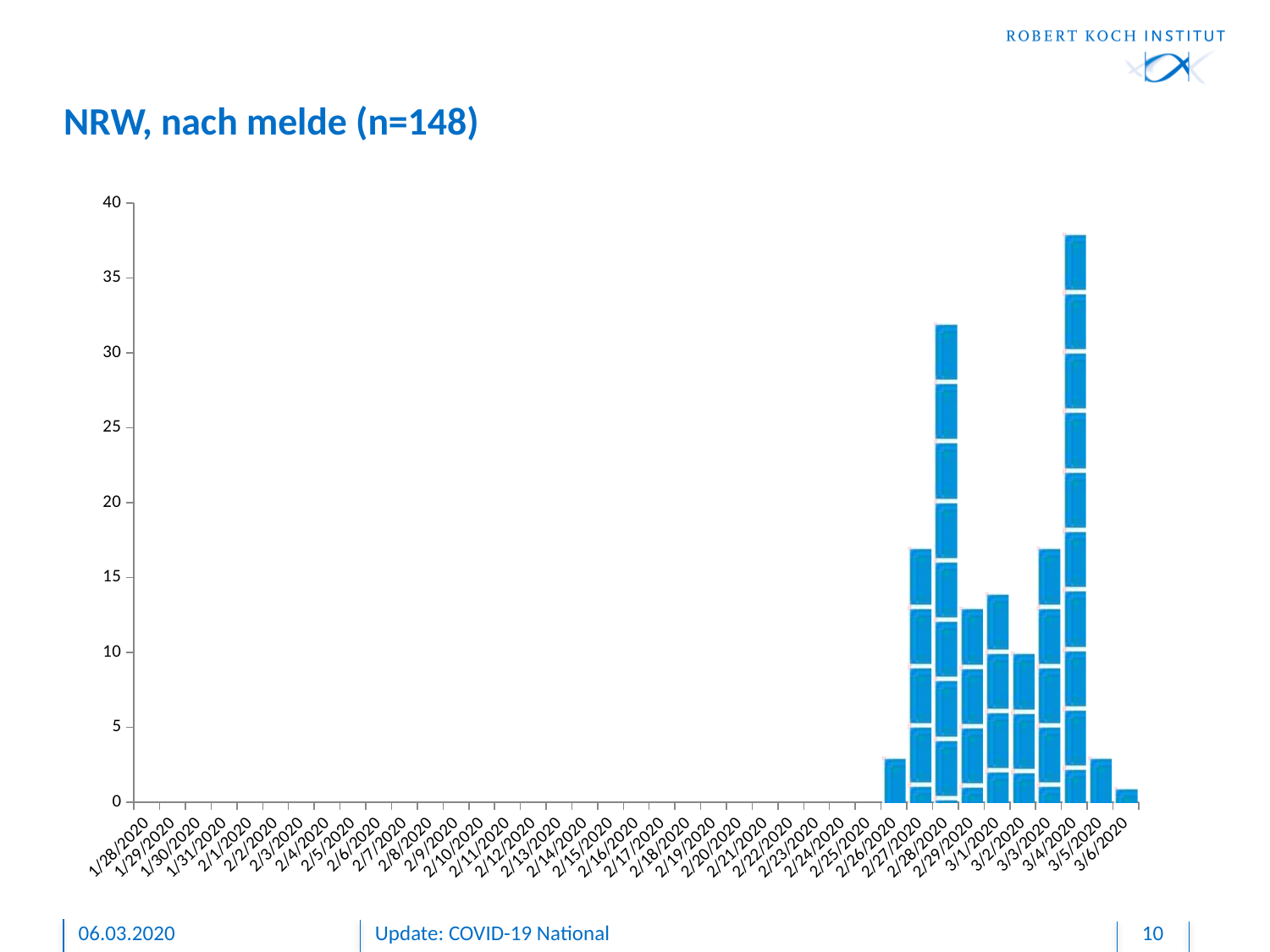
Which is larger, the value for 2/29/2020 or the value for 3/2/2020? 2/29/2020 Is the value for 3/6/2020 greater or less than 5? less Is the value for 3/2/2020 greater or less than 15? less Is the value for 2/26/2020 greater or less than 5? less Which is larger, the value for 2/28/2020 or the value for 3/4/2020? 3/4/2020 Which date has the highest bar? 3/4/2020 Do the values rise or fall from 2/26/2020 to 2/28/2020? rise What is the title of the chart? NRW, nach melde (n=148) What kind of chart is shown on the slide? bar chart